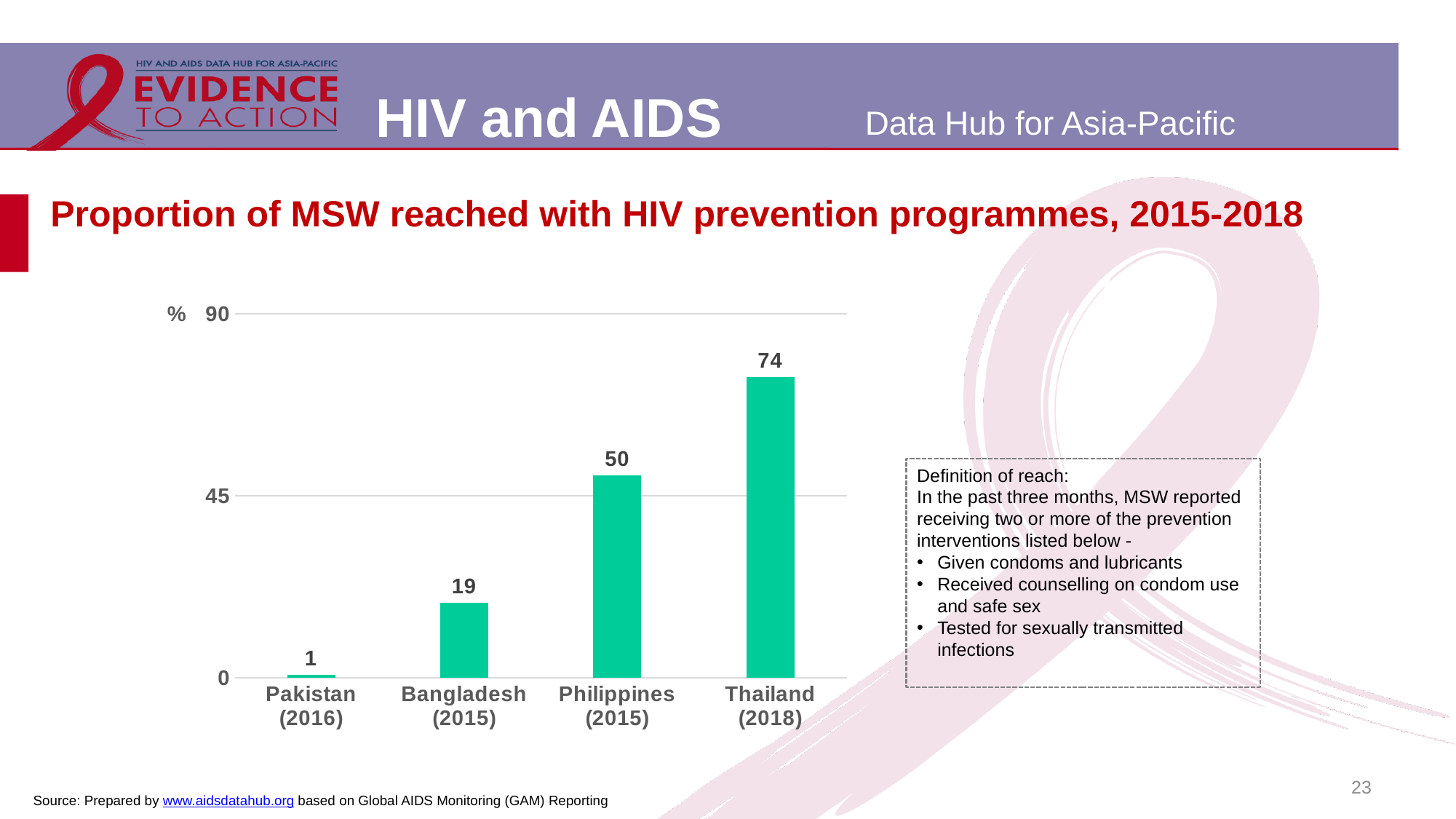
Is the value for Thailand (2018) greater or less than 45? greater How many countries are shown in the chart? 4 What is the value for Bangladesh (2015)? 19 Which country has the highest proportion of MSW reached? Thailand (2018) What kind of chart is shown on the slide? bar chart What is the title of the chart? Proportion of MSW reached with HIV prevention programmes, 2015-2018 What is the value for Thailand (2018)? 74 Which is larger, the value for Bangladesh (2015) or Philippines (2015)? Philippines (2015) What is the value for Pakistan (2016)? 1 What is the value for Philippines (2015)? 50 Which country has the lowest proportion of MSW reached? Pakistan (2016) What is the difference between the values for Thailand (2018) and Philippines (2015)? 24